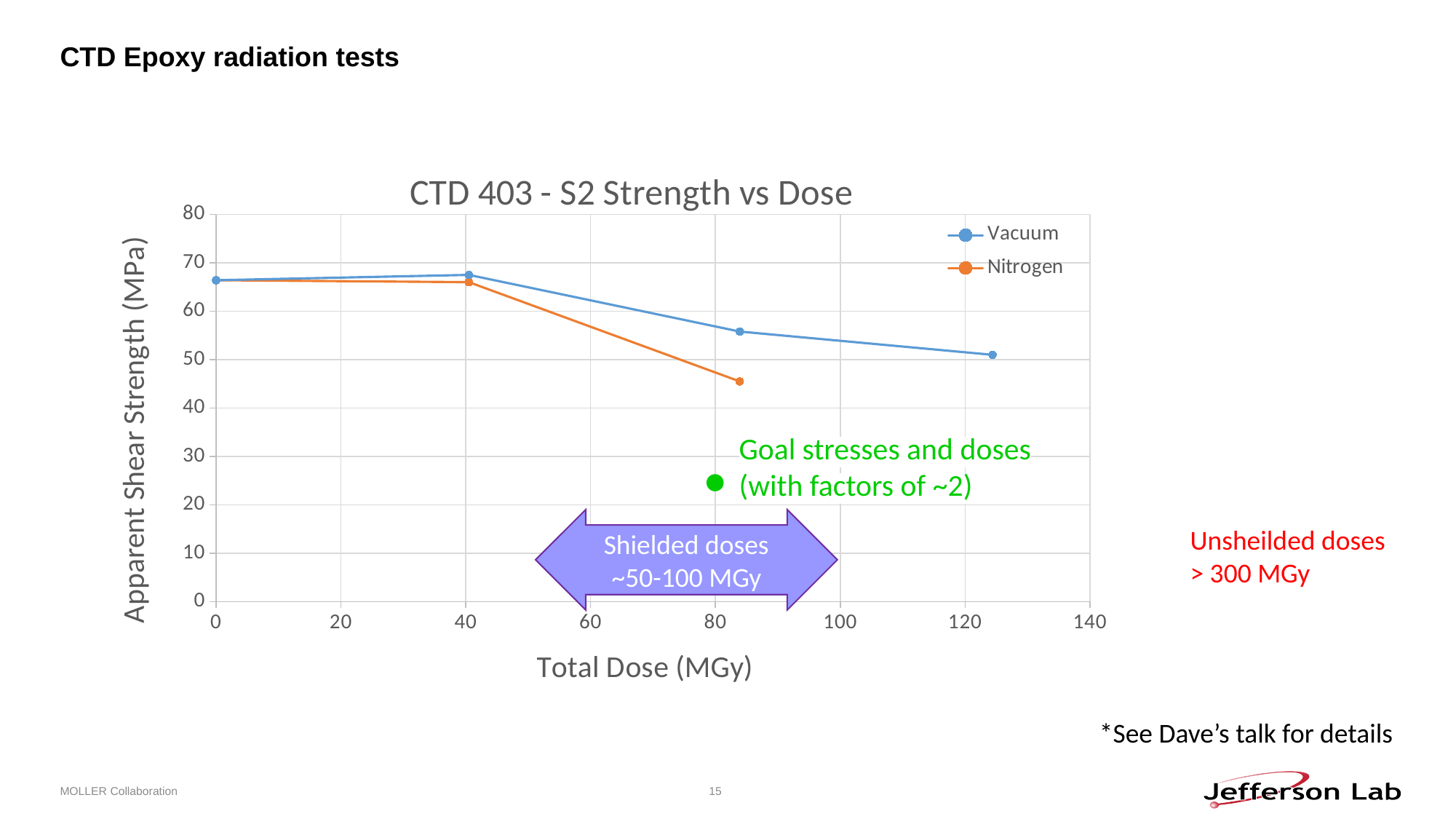
At a total dose of about 84 MGy, which series has the higher apparent shear strength, Vacuum or Nitrogen? Vacuum How many data points are plotted for the Vacuum series? 4 How many series does the chart legend list? 2 What is the title of the chart? CTD 403 - S2 Strength vs Dose Is the apparent shear strength of the Vacuum series at a dose of 0 MGy greater or less than 60 MPa? greater What kind of chart is shown on the slide? line chart Is the apparent shear strength of the Nitrogen series at its highest dose (about 84 MGy) greater or less than 50 MPa? less Does the apparent shear strength for the Nitrogen series rise or fall as total dose increases beyond 40 MGy? fall What is the label of the x axis of the chart? Total Dose (MGy) Which series reaches the lowest apparent shear strength on the chart? Nitrogen How many data points are plotted for the Nitrogen series? 3 Is the apparent shear strength of the Vacuum series at its highest dose (about 124 MGy) greater or less than 60 MPa? less